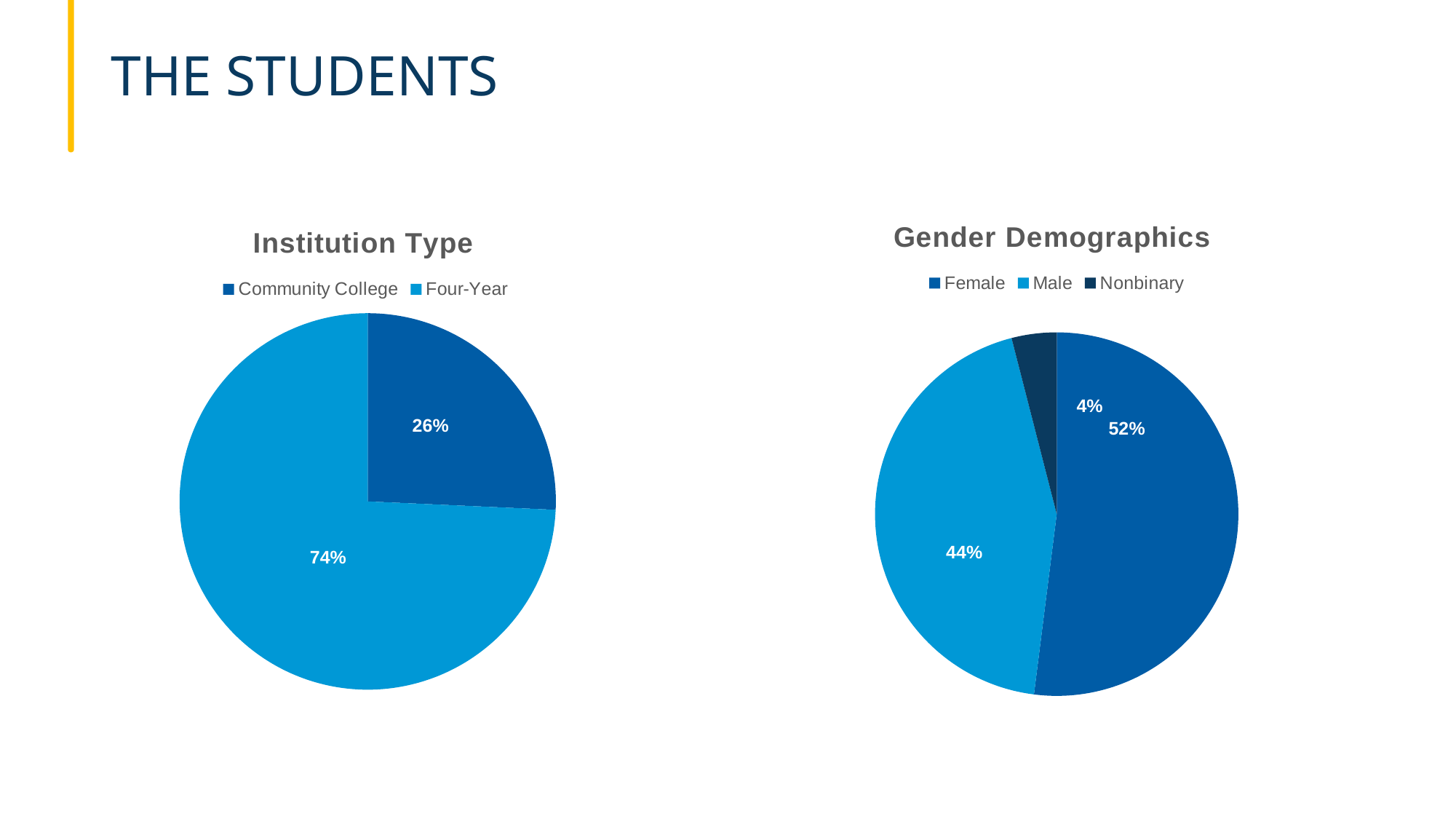
In the Gender Demographics chart, what is the difference in percentage points between Female and Male? 8 In the Institution Type chart, what is the difference in percentage points between Four-Year and Community College? 48 What type of chart is the Institution Type chart? Pie chart How many categories does the Gender Demographics chart show? 3 In the Gender Demographics chart, what share of students are Male? 44% In the Gender Demographics chart, what share of students are Nonbinary? 4% In the Institution Type chart, which category has the largest slice? Four-Year In the Gender Demographics chart, which is larger, Female or Male? Female In the Institution Type chart, what share of students attend a Four-Year institution? 74% In the Gender Demographics chart, which category has the smallest slice? Nonbinary In the Institution Type chart, what share of students attend a Community College? 26% In the Gender Demographics chart, what share of students are Female? 52%